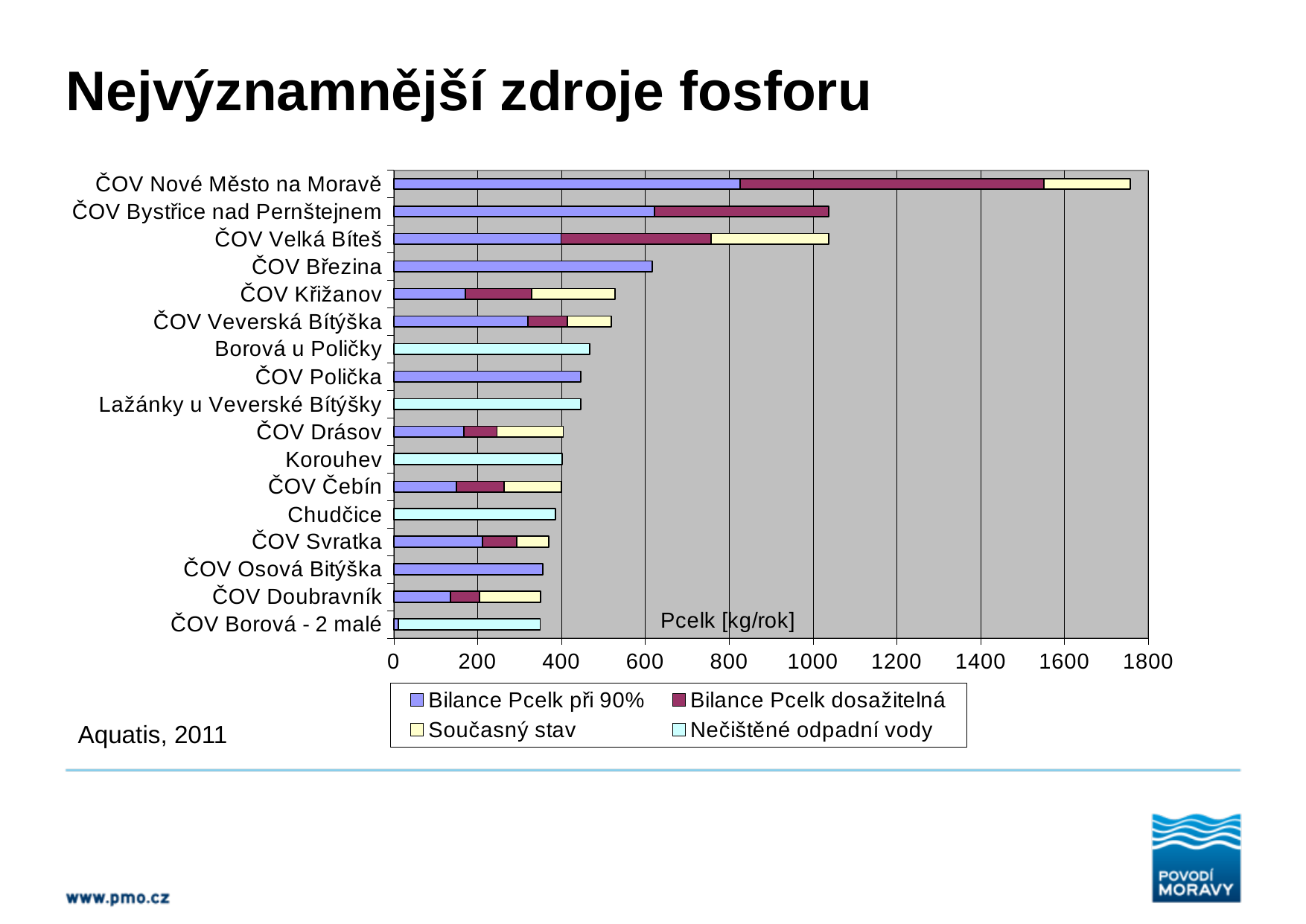
Is the total bar for ČOV Nové Město na Moravě greater or less than 1600? greater What kind of chart is shown on the slide? Stacked horizontal bar chart Which category has the longest total bar? ČOV Nové Město na Moravě How many series does the chart legend list? 4 Is the total bar for ČOV Velká Bíteš greater or less than 800? greater How many categories (sources) are plotted on the chart? 17 Is the value for ČOV Osová Bitýška greater or less than 400? less Are the bars ordered from longest to shortest going from top to bottom? Yes What unit label is shown on the chart's value axis? Pcelk [kg/rok] What is the title of the slide containing the chart? Nejvýznamnější zdroje fosforu Which has the larger total bar, ČOV Nové Město na Moravě or ČOV Bystřice nad Pernštejnem? ČOV Nové Město na Moravě